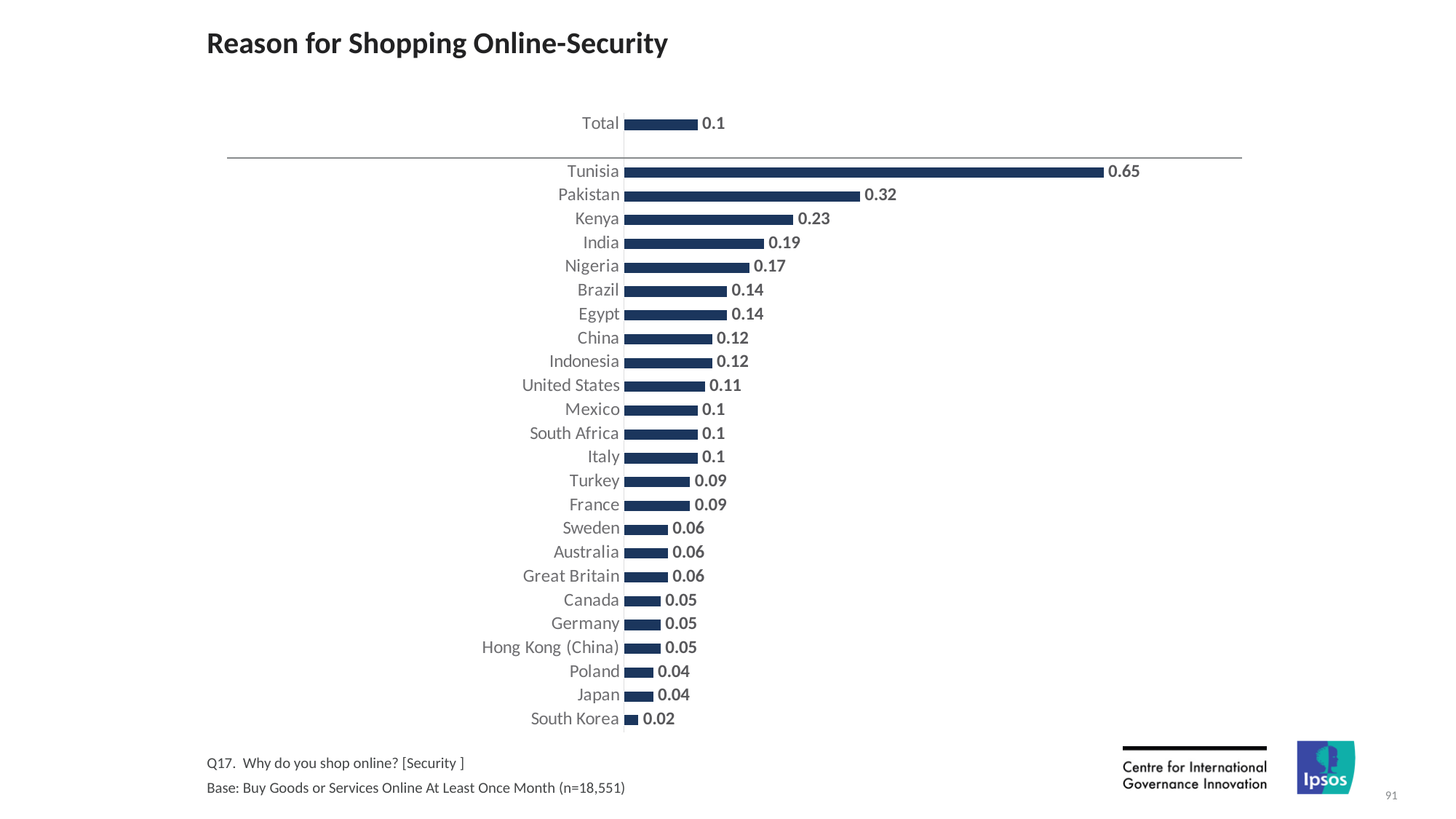
What kind of chart is shown on the slide? Bar chart What is the value for Great Britain? 0.06 Which country has the lowest value? South Korea How many countries are listed below the Total bar? 24 What is the difference between the values for Kenya and India? 0.04 What is the title of the chart? Reason for Shopping Online-Security What is the value for United States? 0.11 What is the value for Tunisia? 0.65 What is the value for the Total bar? 0.1 Which country has the highest value? Tunisia What is the difference between the values for Tunisia and Pakistan? 0.33 Which has a larger value, Nigeria or Brazil? Nigeria